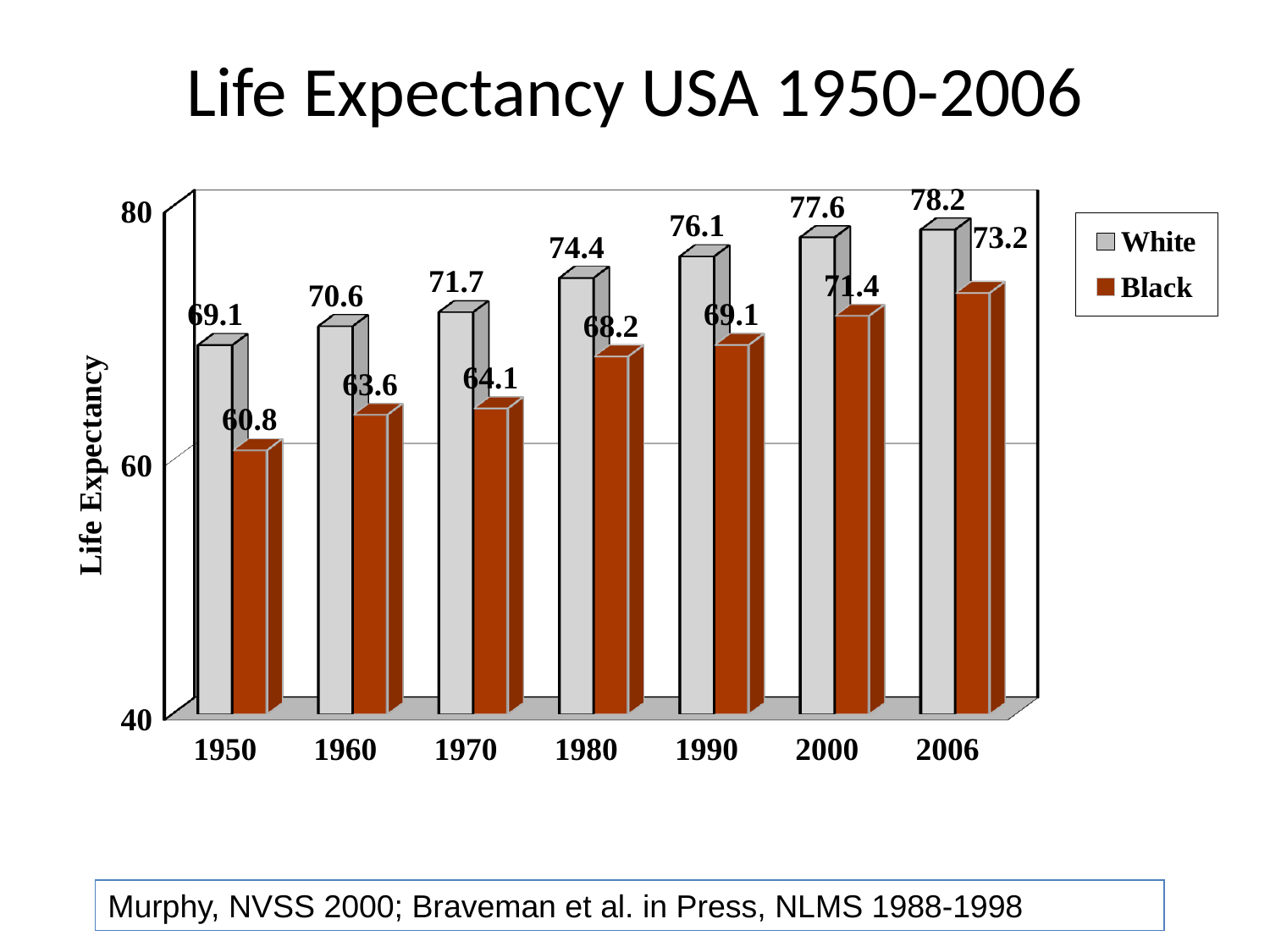
What is the life expectancy for Black in 1980? 68.2 What is the life expectancy for White in 1950? 69.1 In which year is the White life expectancy highest? 2006 What is the difference between White and Black life expectancy in 1950? 8.3 Which is larger, the Black life expectancy in 1990 or the White life expectancy in 1950? They are equal (69.1) How many series does the legend list? 2 In which year is the Black life expectancy lowest? 1950 What kind of chart is shown on the slide? Bar chart Is the Black life expectancy in 1950 greater or less than 60? greater How many years are shown on the x axis? 7 What is the difference between White and Black life expectancy in 2006? 5.0 What is the life expectancy for Black in 2006? 73.2